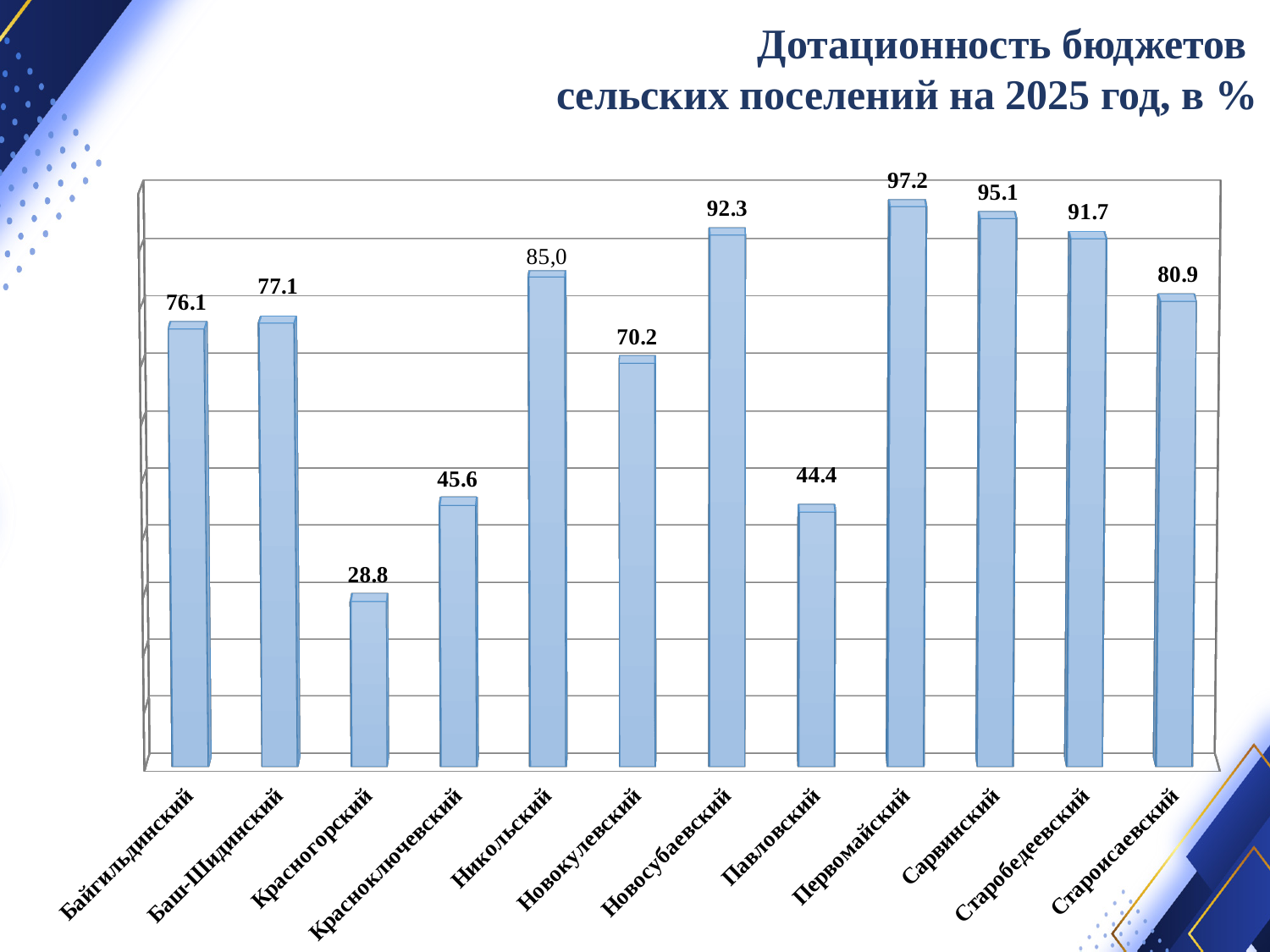
Which is larger, the value for Новосубаевский or the value for Староисаевский? Новосубаевский What is the difference between the values for Первомайский and Красногорский? 68.4 What is the value for Красногорский? 28.8 What is the value for Павловский? 44.4 Which category has the highest value? Первомайский What is the value for Никольский? 85,0 What kind of chart is shown on the slide? Bar chart What is the difference between the values for Баш-Шидинский and Байгильдинский? 1.0 What is the title of the chart? Дотационность бюджетов сельских поселений на 2025 год, в % Which category has the lowest value? Красногорский What is the value for Старобедеевский? 91.7 How many categories are shown on the chart? 12